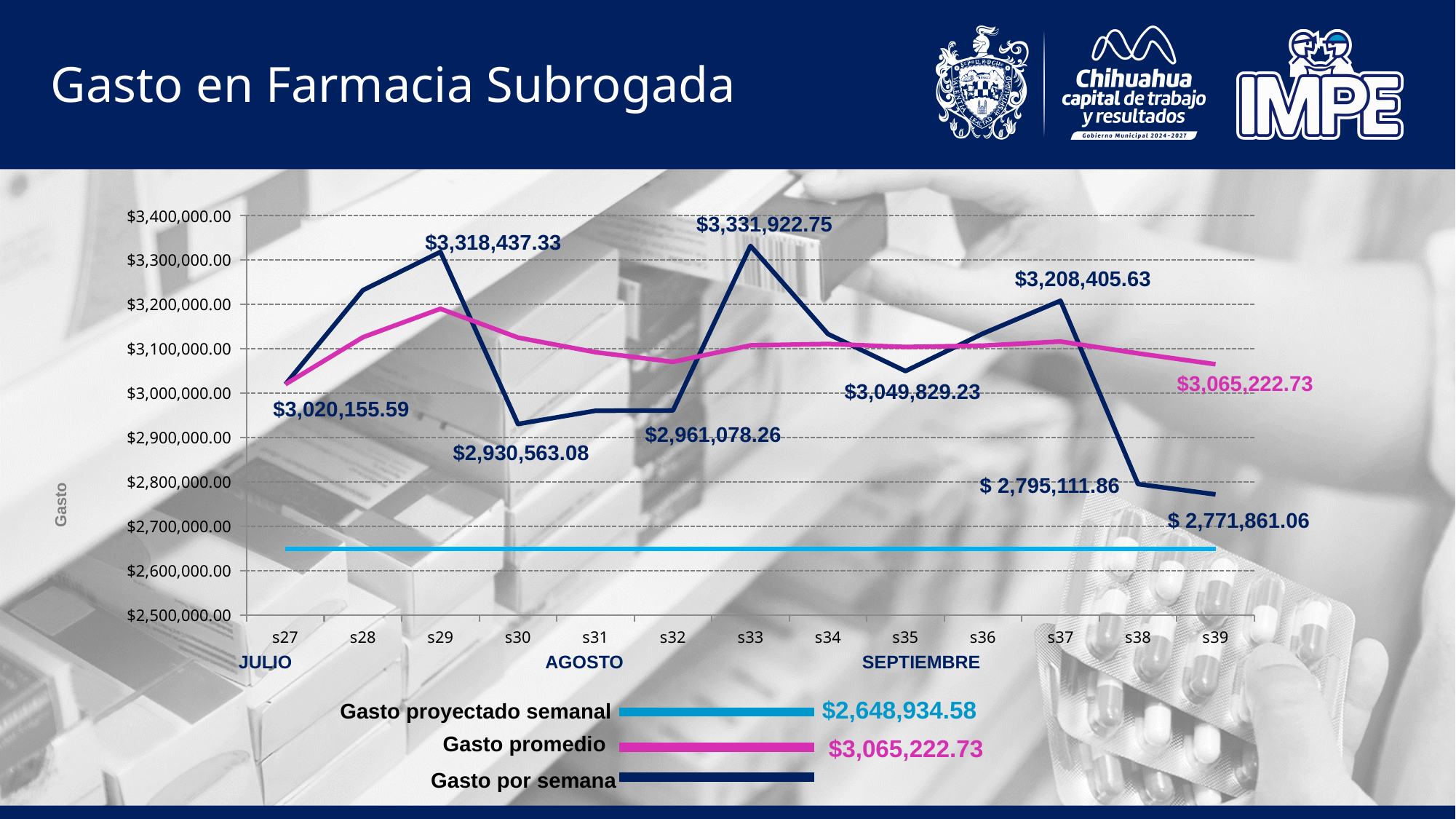
What is the Gasto proyectado semanal value shown in the legend? $2,648,934.58 What type of chart is shown on the slide? Line chart How many weeks are plotted along the x axis? 13 What is the Gasto por semana value for week s29? $3,318,437.33 What is the Gasto por semana value for week s33? $3,331,922.75 Is the Gasto por semana value for s28 greater or less than $3,200,000.00? greater Which week has the highest Gasto por semana value? s33 Which is larger, the Gasto por semana value for s37 or for s35? s37 Which week has the lowest Gasto por semana value? s39 What is the Gasto promedio value shown in the legend? $3,065,222.73 What is the difference between the Gasto por semana values for s29 and s30? $387,874.25 How many series does the legend list? 3